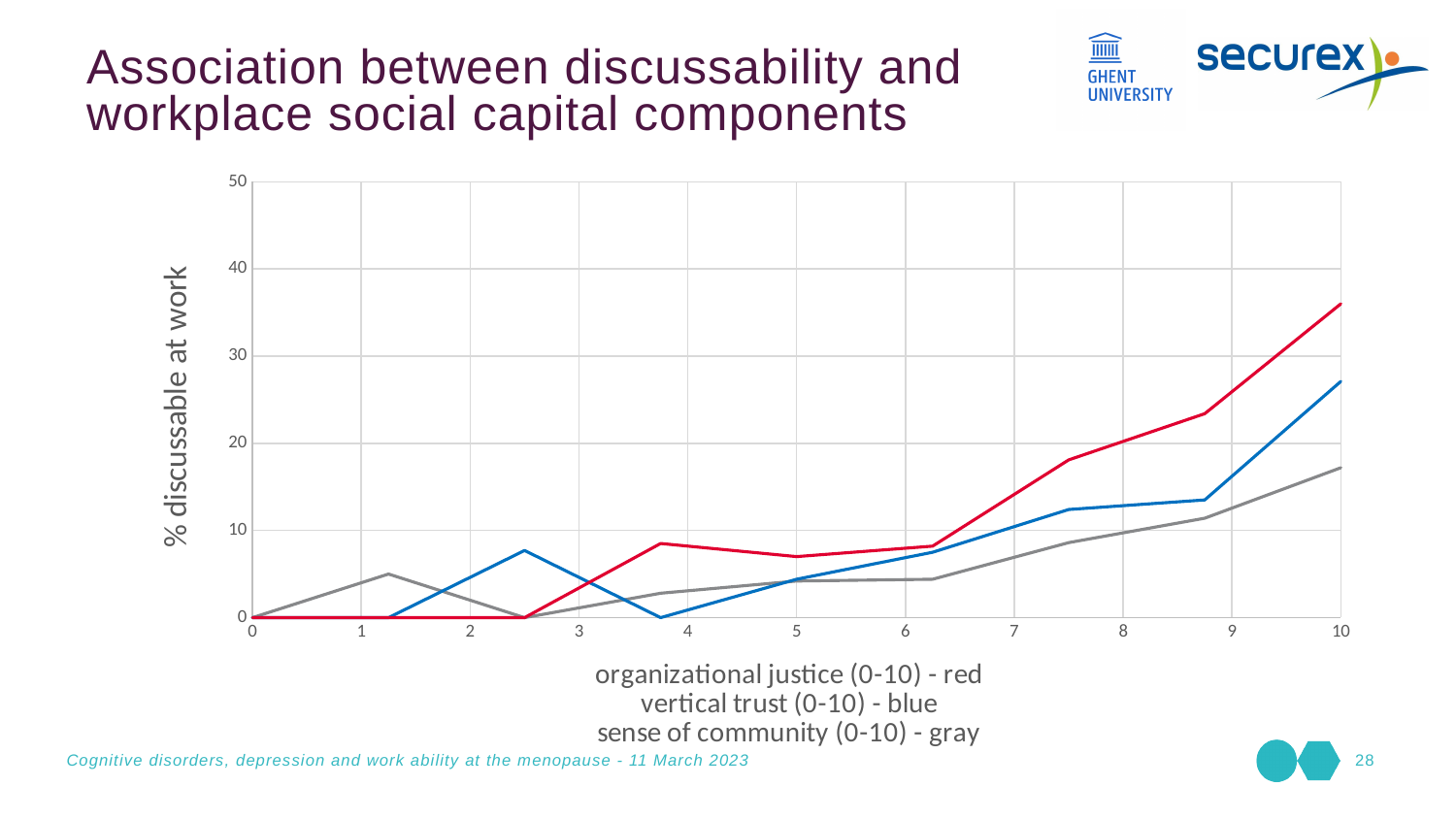
Is the value of the red (organizational justice) line at x = 9 greater or less than 20? greater At x = 10, which line is higher: the blue (vertical trust) line or the gray (sense of community) line? blue (vertical trust) How many series are plotted on the chart? 3 Which colour represents vertical trust on the chart? blue What is the label of the y axis? % discussable at work Is the value of the red (organizational justice) line at x = 10 greater or less than 30? greater Which series reaches the highest value at x = 10? organizational justice (red) At x = 10, which line is higher: the red (organizational justice) line or the blue (vertical trust) line? red (organizational justice) Is the value of the blue (vertical trust) line at x = 5 greater or less than 10? less Does the red (organizational justice) line generally rise or fall as x increases from 5 to 10? rise What kind of chart is shown on the slide? line chart